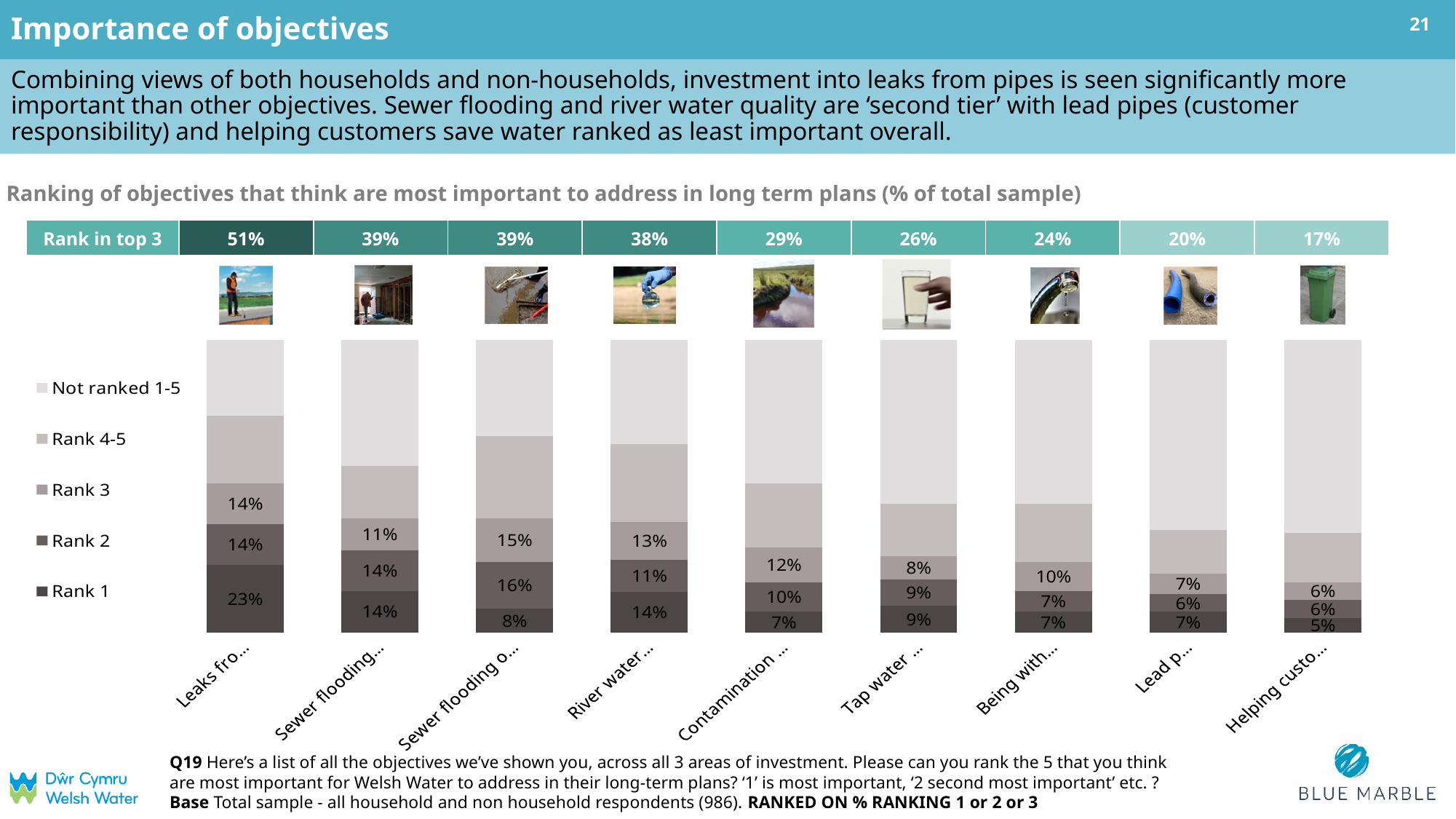
What is the Rank 1 value for the first bar (Leaks fro...)? 23% Which objective has the highest Rank 1 value? Leaks fro... (first bar) Do the 'Rank in top 3' values rise or fall moving from left to right across the bars? Fall How many series does the chart legend list? 5 What is the combined total of Rank 1, Rank 2 and Rank 3 for the Tap water ... bar? 26% Which objective has the lowest Rank 1 value? Helping custo... (last bar) What kind of chart is shown on the slide? Stacked bar chart Which is larger: the Rank 2 value for Sewer flooding o... or the Rank 2 value for Leaks fro...? Sewer flooding o... (16%) What is the Rank 3 value for the Being with... bar? 10% How many objectives (bars) are plotted in the chart? 9 What is the 'Rank in top 3' value shown above the last bar (Helping custo...)? 17% What is the difference between the Rank 1 value for Leaks fro... (23%) and the Rank 1 value for River water ... (14%)? 9 percentage points